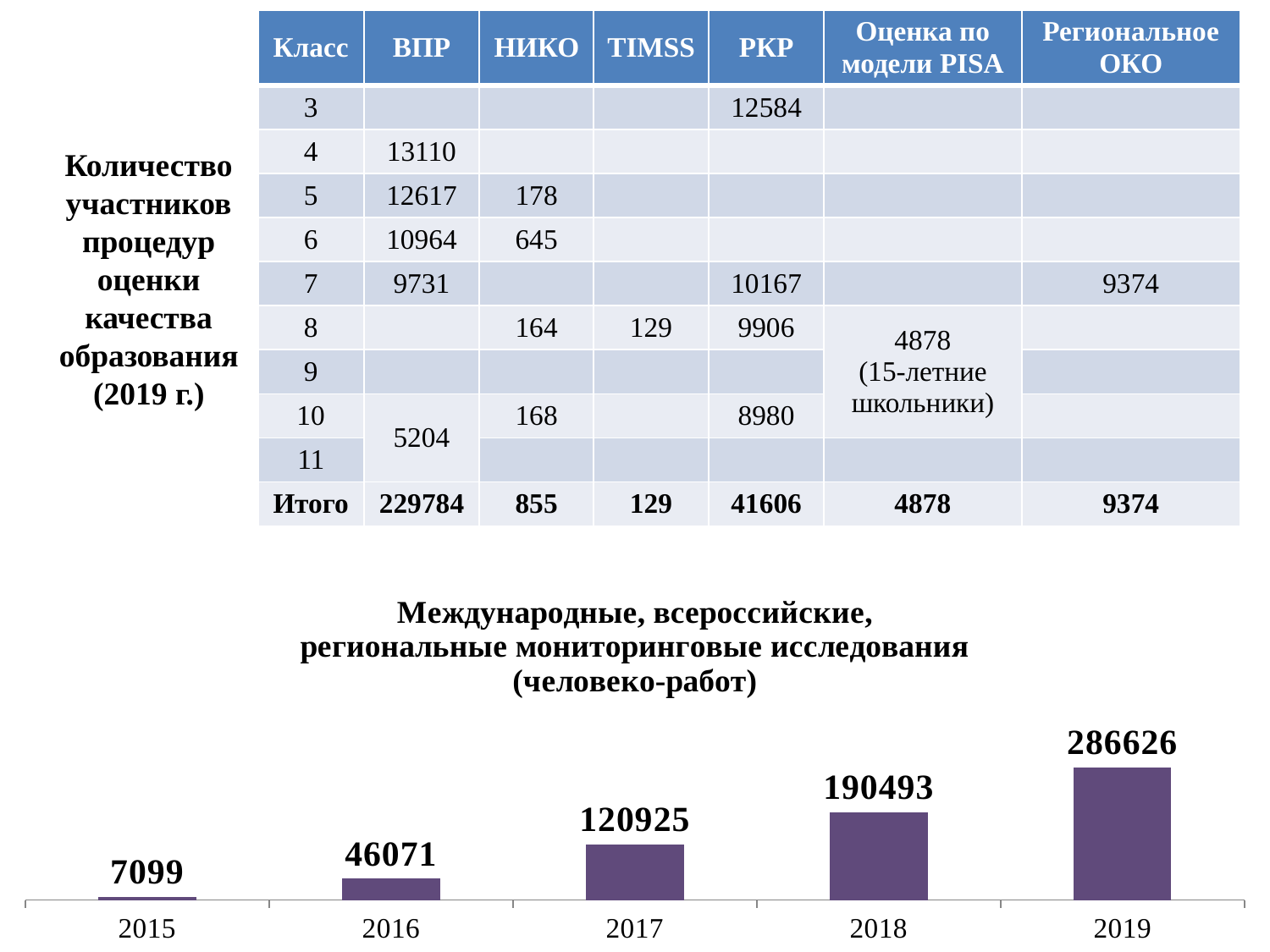
What is the value for 2017 in the bar chart? 120925 What is the difference between the values for 2019 and 2018 in the bar chart? 96133 What kind of chart is shown at the bottom of the slide? bar chart What is the value for 2015 in the bar chart? 7099 Which year has the lowest value in the bar chart? 2015 Which is larger in the bar chart, the value for 2017 or the value for 2018? 2018 Do the values in the bar chart rise or fall from 2015 to 2019? rise What is the value for 2019 in the bar chart? 286626 What is the difference between the values for 2016 and 2015 in the bar chart? 38972 What is the title of the bar chart? Международные, всероссийские, региональные мониторинговые исследования (человеко-работ) Which year has the highest value in the bar chart? 2019 How many years are shown in the bar chart? 5